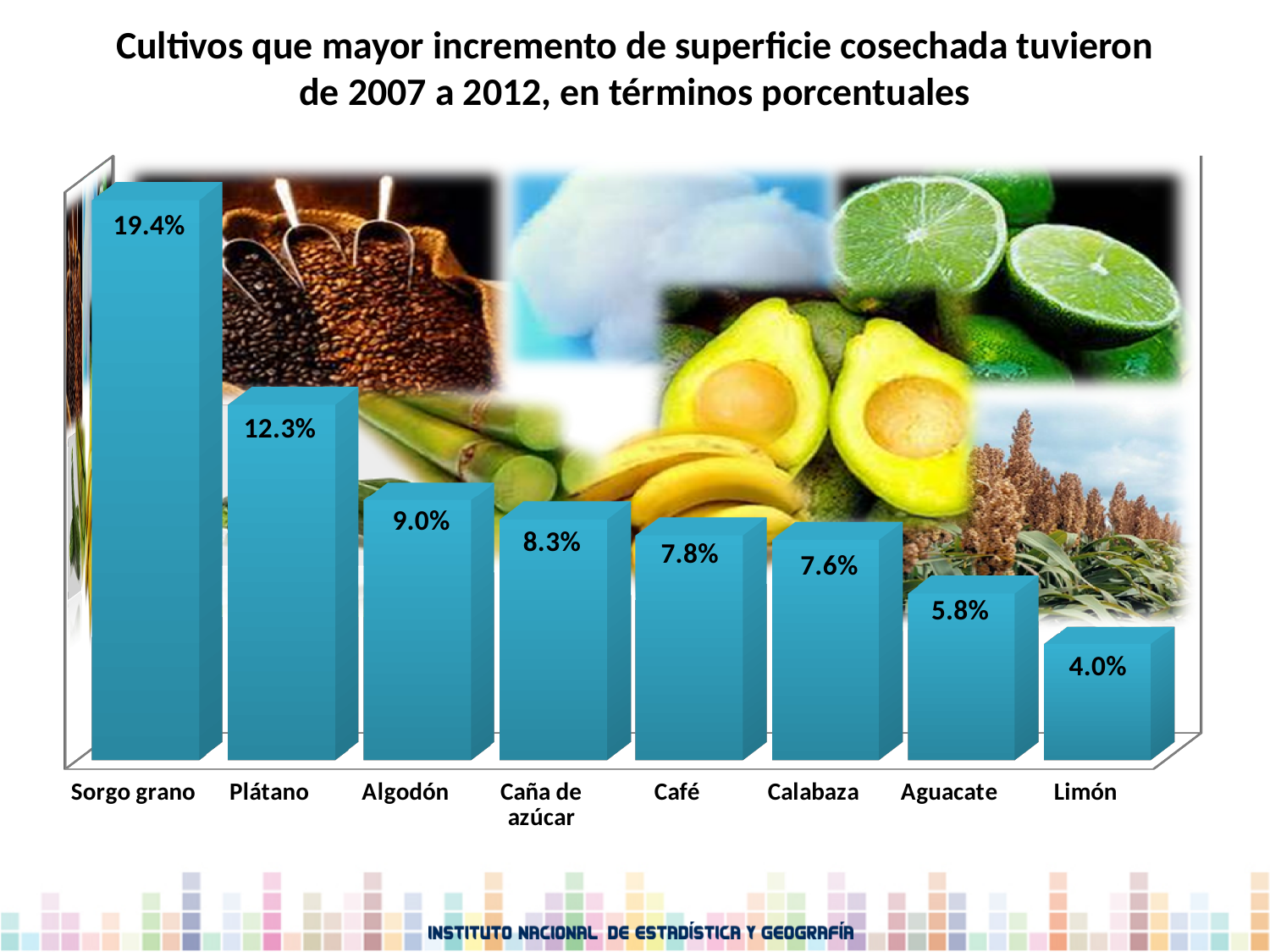
What is the difference between the values for Sorgo grano and Plátano? 7.1% What is the value for Sorgo grano? 19.4% What is the difference between the values for Algodón and Limón? 5.0% What kind of chart is shown on the slide? Bar chart Which crop has the highest value? Sorgo grano Do the values rise or fall from left to right across the crops? Fall Which crop has the lowest value? Limón What is the value for Aguacate? 5.8% How many crops are shown in the chart? 8 What is the value for Caña de azúcar? 8.3% Which is larger, the value for Plátano or the value for Café? Plátano What is the title of the chart? Cultivos que mayor incremento de superficie cosechada tuvieron de 2007 a 2012, en términos porcentuales